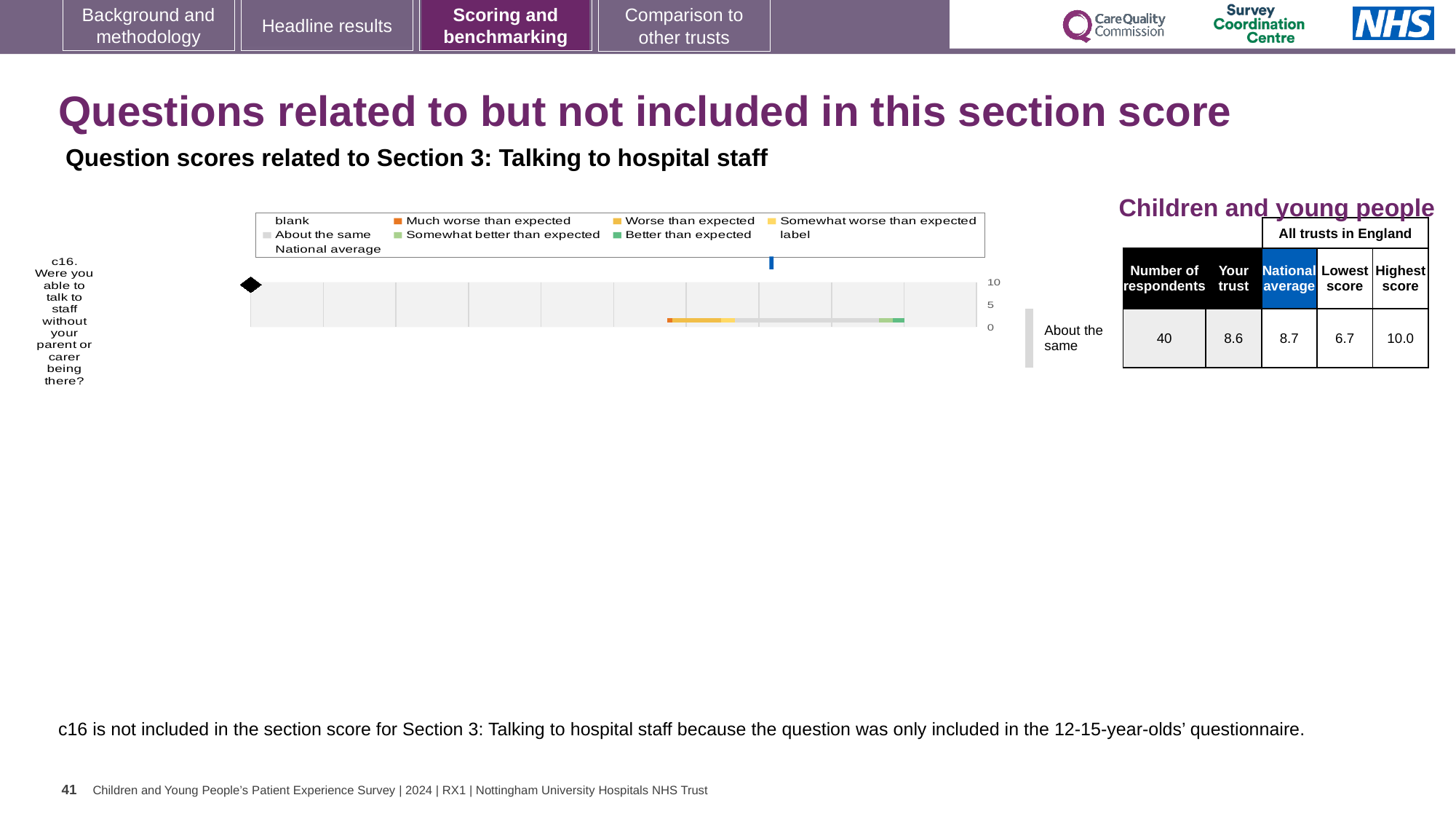
What kind of chart is shown on the slide for question c16? bar chart What is the highest value shown on the chart's score axis? 10 What benchmark rating is shown next to the chart for question c16? About the same In the table beside the chart, what is the difference between the highest score and the lowest score for c16? 3.3 In the table beside the chart, what is the highest score among all trusts in England for c16? 10.0 In the table beside the chart, what is the 'Your trust' score for c16? 8.6 In the table beside the chart, how many respondents answered c16? 40 How many survey questions are plotted in the chart? 1 Which colour in the chart legend represents 'Much worse than expected'? orange In the table beside the chart, what is the national average score for c16? 8.7 In the table beside the chart, what is the lowest score among all trusts in England for c16? 6.7 In the table beside the chart, which is larger for c16: the 'Your trust' score or the national average? National average